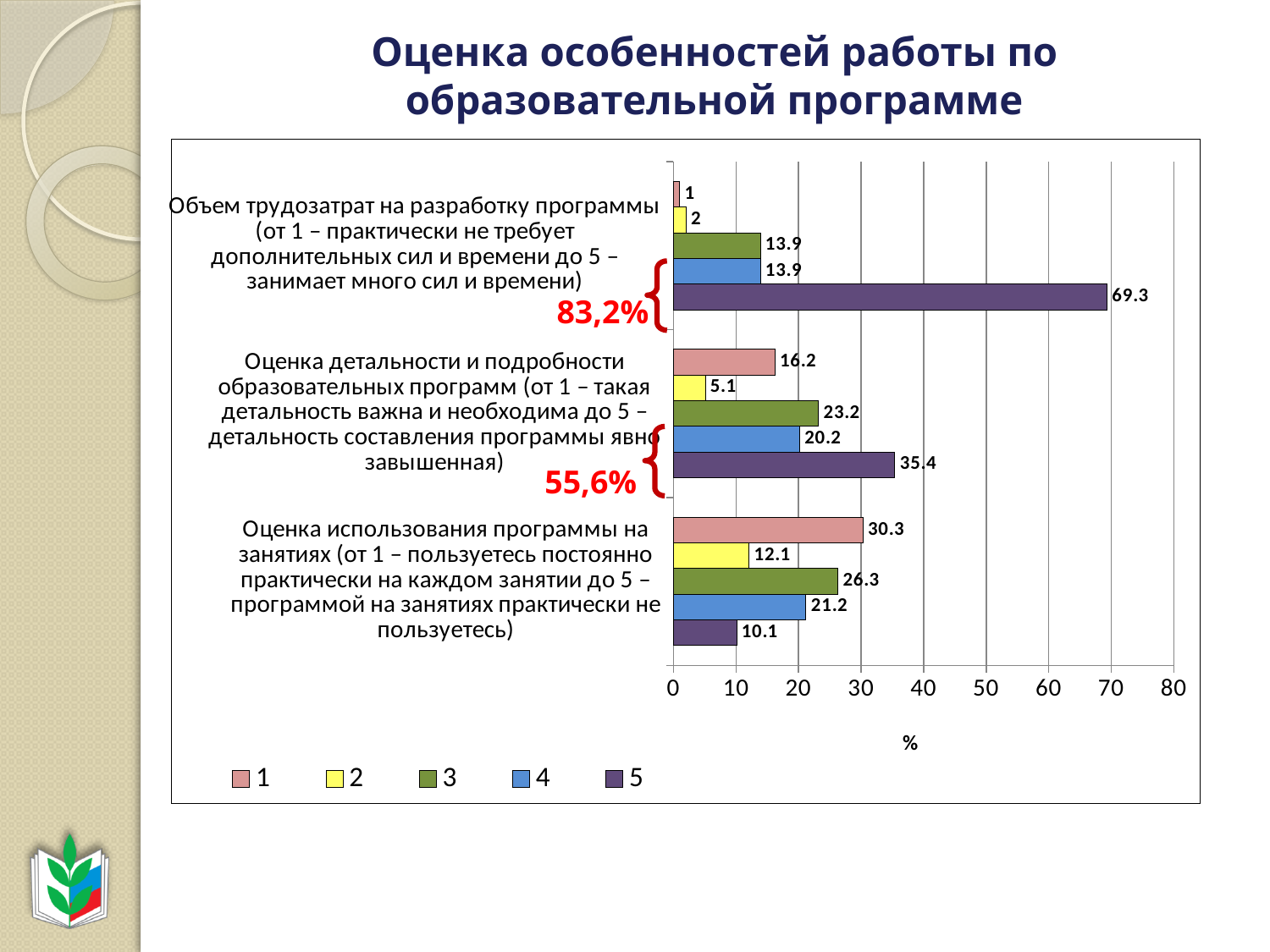
What is the value for series 5 in the category "Объем трудозатрат на разработку программы"? 69.3 Which series has the highest value in the category "Оценка детальности и подробности образовательных программ"? 5 Which series has the lowest value in the category "Оценка использования программы на занятиях"? 5 How many series does the legend list? 5 In the category "Оценка использования программы на занятиях", which is larger: series 3 or series 4? series 3 What is the value for series 1 in the category "Оценка использования программы на занятиях"? 30.3 What is the difference between series 5 and series 4 in the category "Объем трудозатрат на разработку программы"? 55.4 What unit is shown on the horizontal axis label of the chart? % What is the value for series 2 in the category "Оценка детальности и подробности образовательных программ"? 5.1 How many categories are shown on the chart? 3 Is the value for series 5 in the category "Объем трудозатрат на разработку программы" greater or less than 60? greater What kind of chart is shown on the slide? bar chart